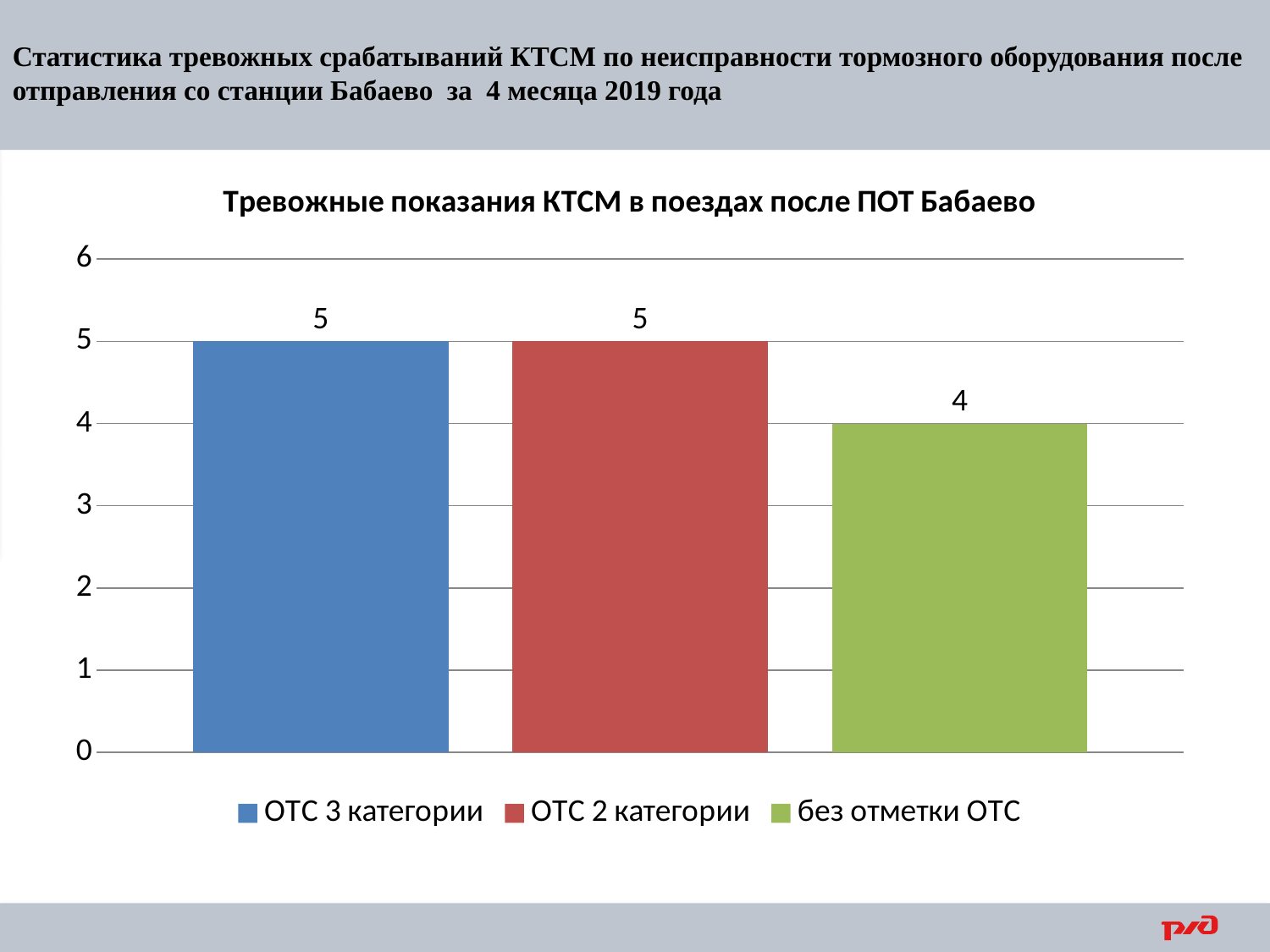
How many entries does the legend list? 3 Is the value for без отметки ОТС greater or less than 5? less How many bars are shown in the chart? 3 What kind of chart is shown on the slide? bar chart What is the value for ОТС 3 категории? 5 Which category has the lowest value? без отметки ОТС What is the value for без отметки ОТС? 4 What is the title of the chart? Тревожные показания КТСМ в поездах после ПОТ Бабаево What is the value for ОТС 2 категории? 5 What colour is the bar for ОТС 2 категории? red Which is larger, the value for ОТС 2 категории or the value for без отметки ОТС? ОТС 2 категории What is the difference between the values for ОТС 3 категории and без отметки ОТС? 1